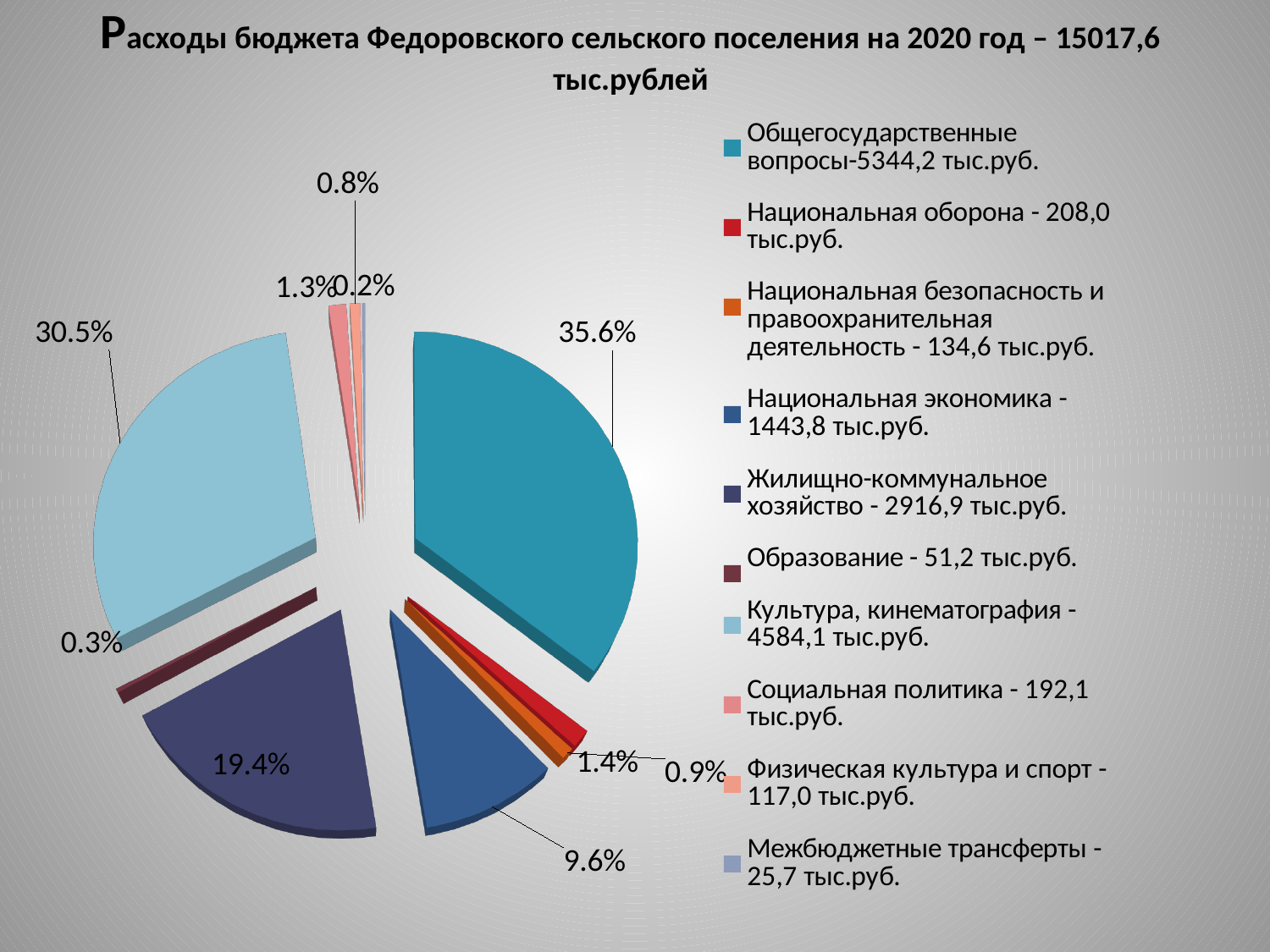
What kind of chart is shown on the slide? pie chart According to the legend, what is the amount for Образование? 51,2 тыс.руб. Which category has the smallest slice of the pie? Межбюджетные трансферты According to the legend, what is the amount for Национальная оборона? 208,0 тыс.руб. How many categories does the legend of the pie chart list? 10 What share of the pie does Национальная экономика take? 9.6% What is the difference in percentage points between the Общегосударственные вопросы slice and the Культура, кинематография slice? 5.1% What share of the pie does Культура, кинематография take? 30.5% Which category has the largest slice of the pie? Общегосударственные вопросы Which slice is larger: Культура, кинематография or Жилищно-коммунальное хозяйство? Культура, кинематография What share of the pie does Общегосударственные вопросы take? 35.6%